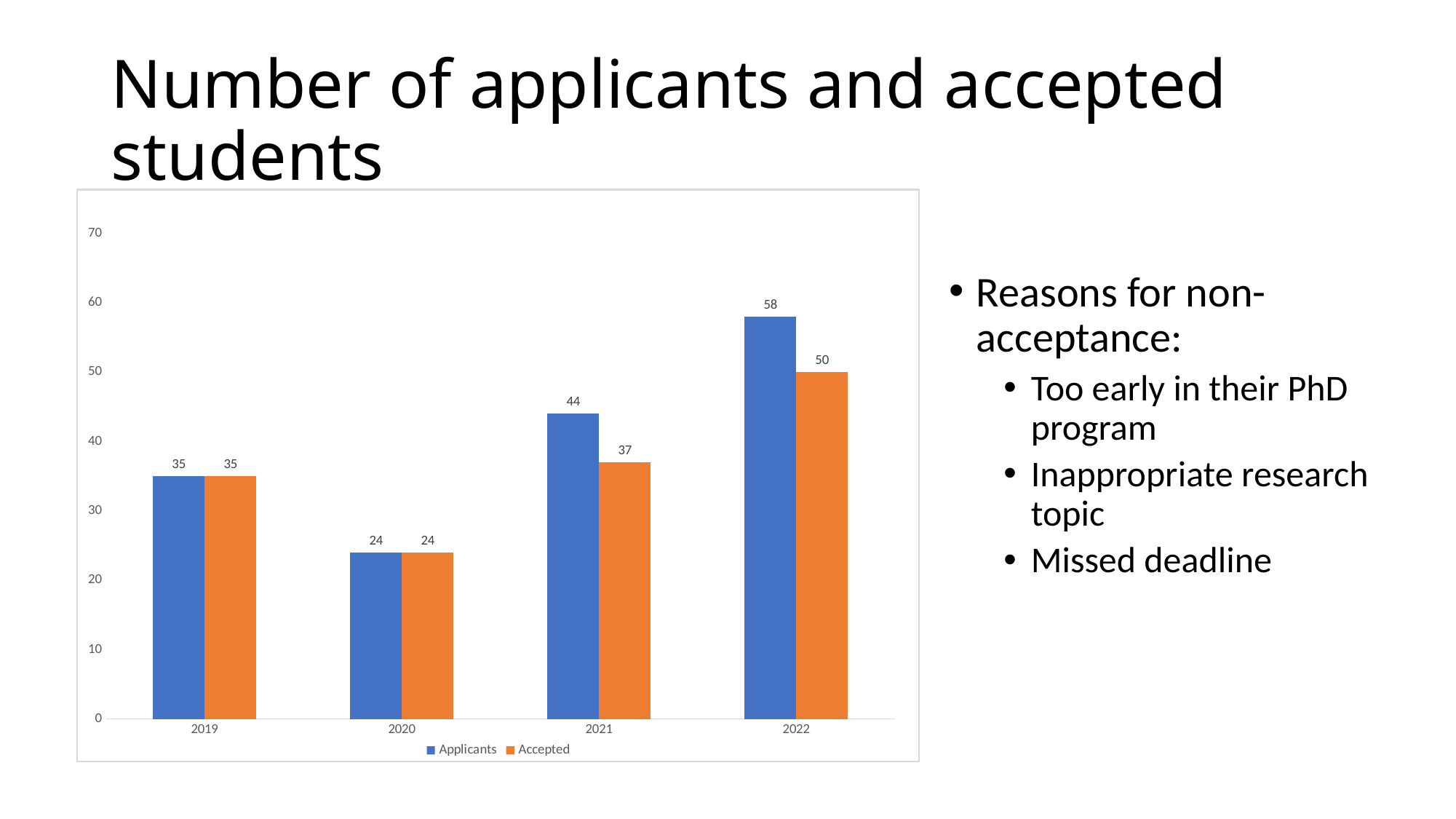
Which series is shown in orange in the legend? Accepted Which year has the lowest number of accepted students? 2020 Which year has the highest number of applicants? 2022 What is the number of applicants in 2022? 58 Which is larger, the number of applicants in 2019 or in 2021? 2021 How many series does the legend list? 2 What kind of chart is shown on the slide? bar chart What is the number of accepted students in 2021? 37 What is the difference between applicants and accepted students in 2022? 8 What is the number of applicants in 2020? 24 What is the difference between applicants and accepted students in 2021? 7 How many years are shown on the x axis? 4